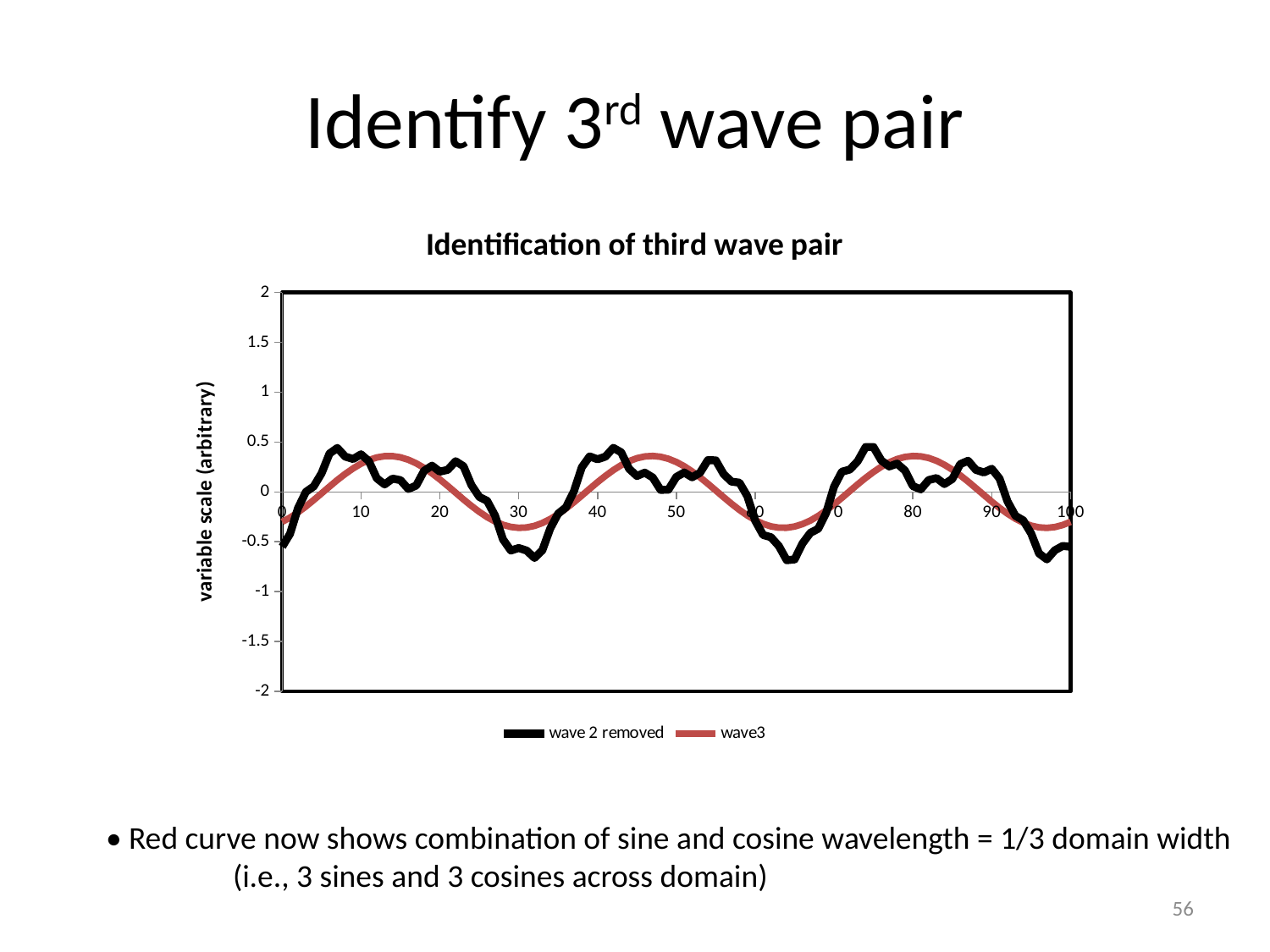
Is the value of the wave3 series at x = 0 greater or less than 0? less What is the title of the chart? Identification of third wave pair Which series is drawn in red in the chart? wave3 Is the value of the 'wave 2 removed' series at x = 40 greater or less than 0? greater Is the highest value reached by the wave3 series greater or less than 0.5? less At x = 0, which series has the lower value, 'wave 2 removed' or wave3? wave 2 removed How many series does the chart legend list? 2 At x = 30, which series has the higher value, 'wave 2 removed' or wave3? wave3 What kind of chart is shown on the slide? line chart